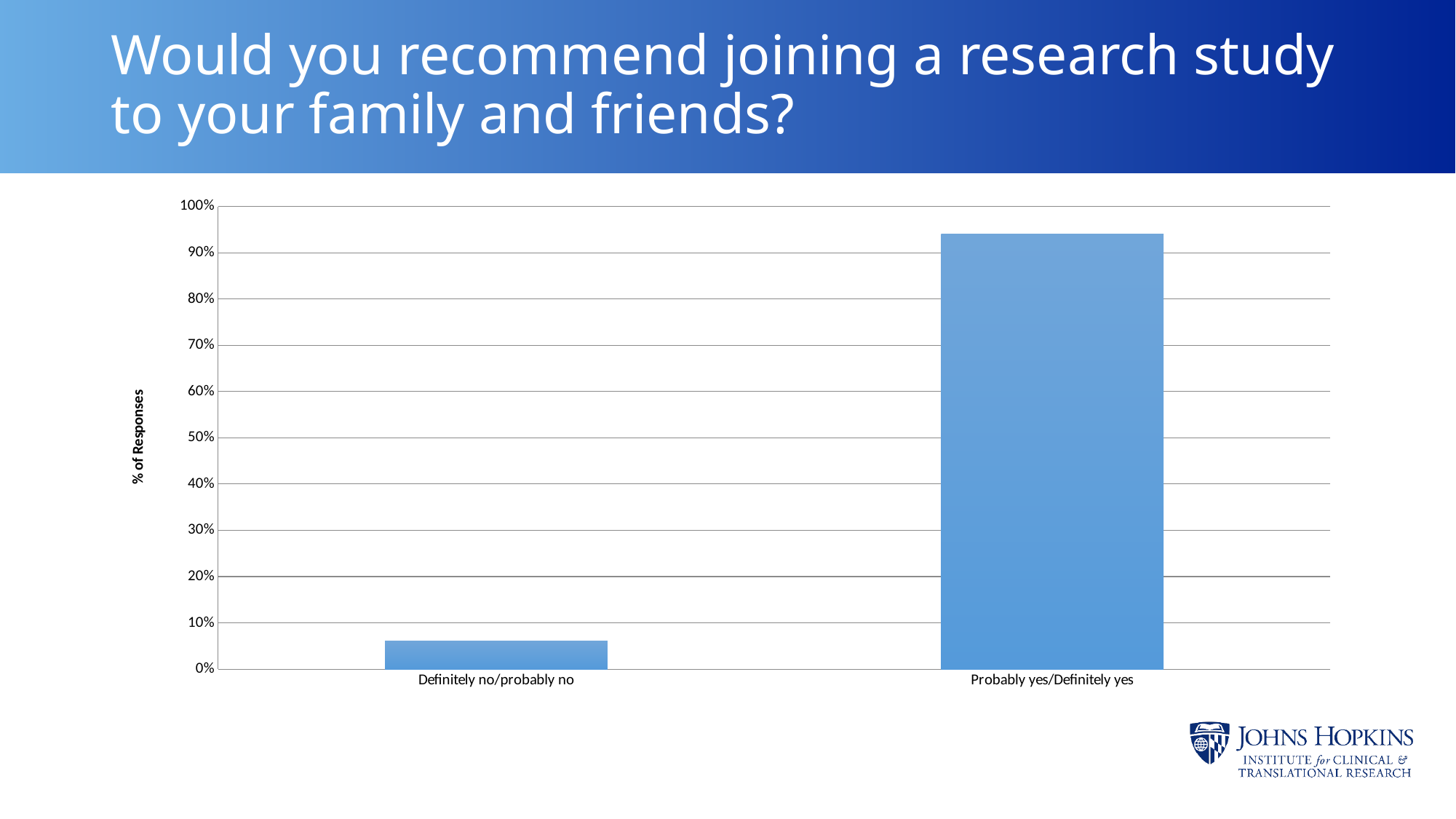
How many categories are shown on the x axis? 2 Which category has the highest value? Probably yes/Definitely yes Is the value for Probably yes/Definitely yes greater or less than 100%? less Is the value for Definitely no/probably no greater or less than 10%? less Which is larger, the value for Definitely no/probably no or the value for Probably yes/Definitely yes? Probably yes/Definitely yes What is the label of the y axis? % of Responses What is the highest tick value shown on the y axis? 100% Which category has the lowest value? Definitely no/probably no Is the value for Probably yes/Definitely yes greater or less than 90%? greater What kind of chart is shown on the slide? bar chart